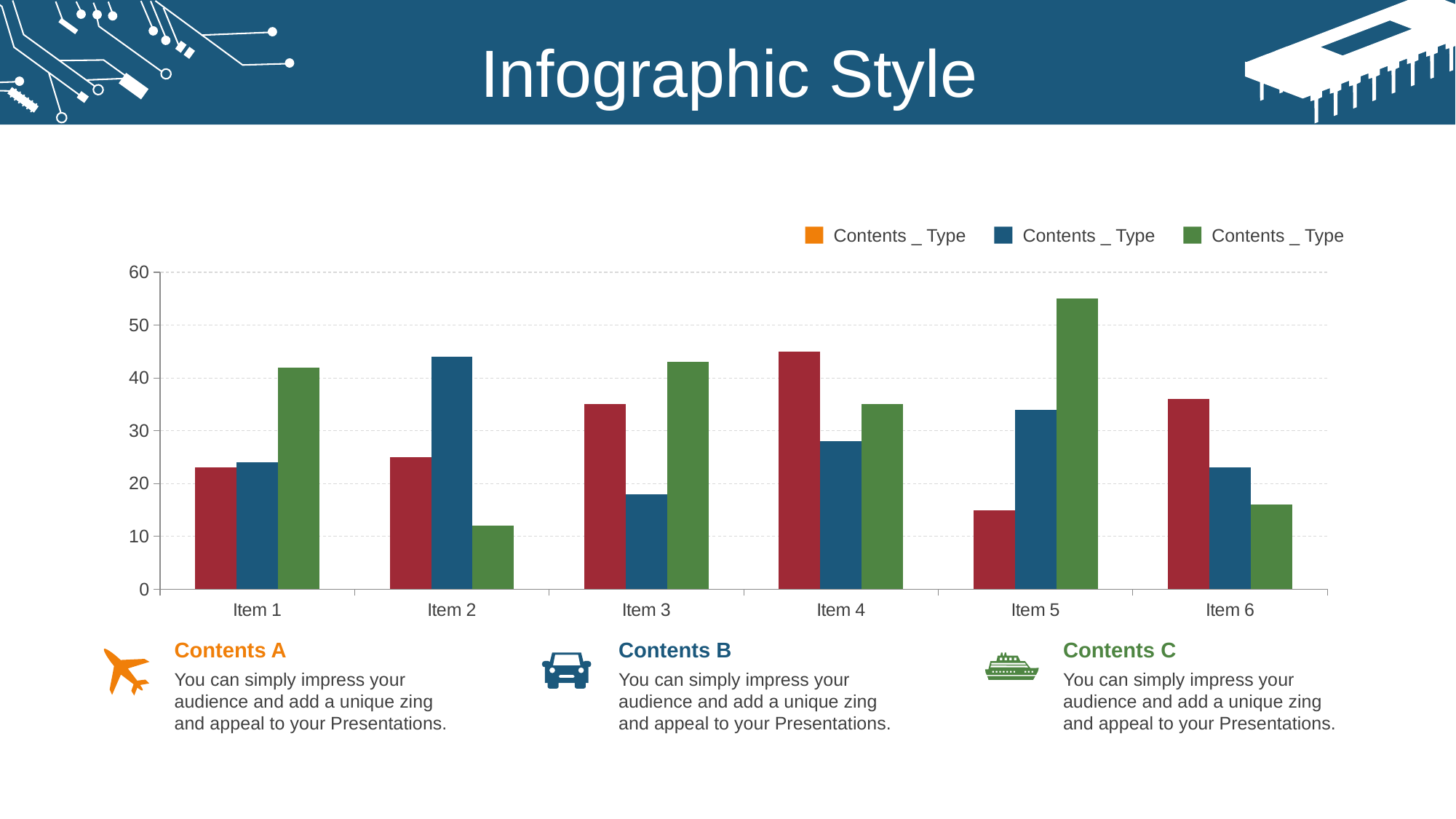
Is the value of the blue bar for Item 2 greater or less than 40? greater Which item has the tallest green bar? Item 5 For Item 4, which is larger: the red bar or the blue bar? the red bar What kind of chart is shown on the slide? bar chart For Item 3, which is larger: the green bar or the blue bar? the green bar Is the value of the green bar for Item 2 greater or less than 20? less How many items (categories) are shown along the x axis? 6 Is the value of the green bar for Item 5 greater or less than 50? greater What is the highest value shown on the y axis? 60 Which item has the shortest red bar? Item 5 How many series does the legend list? 3